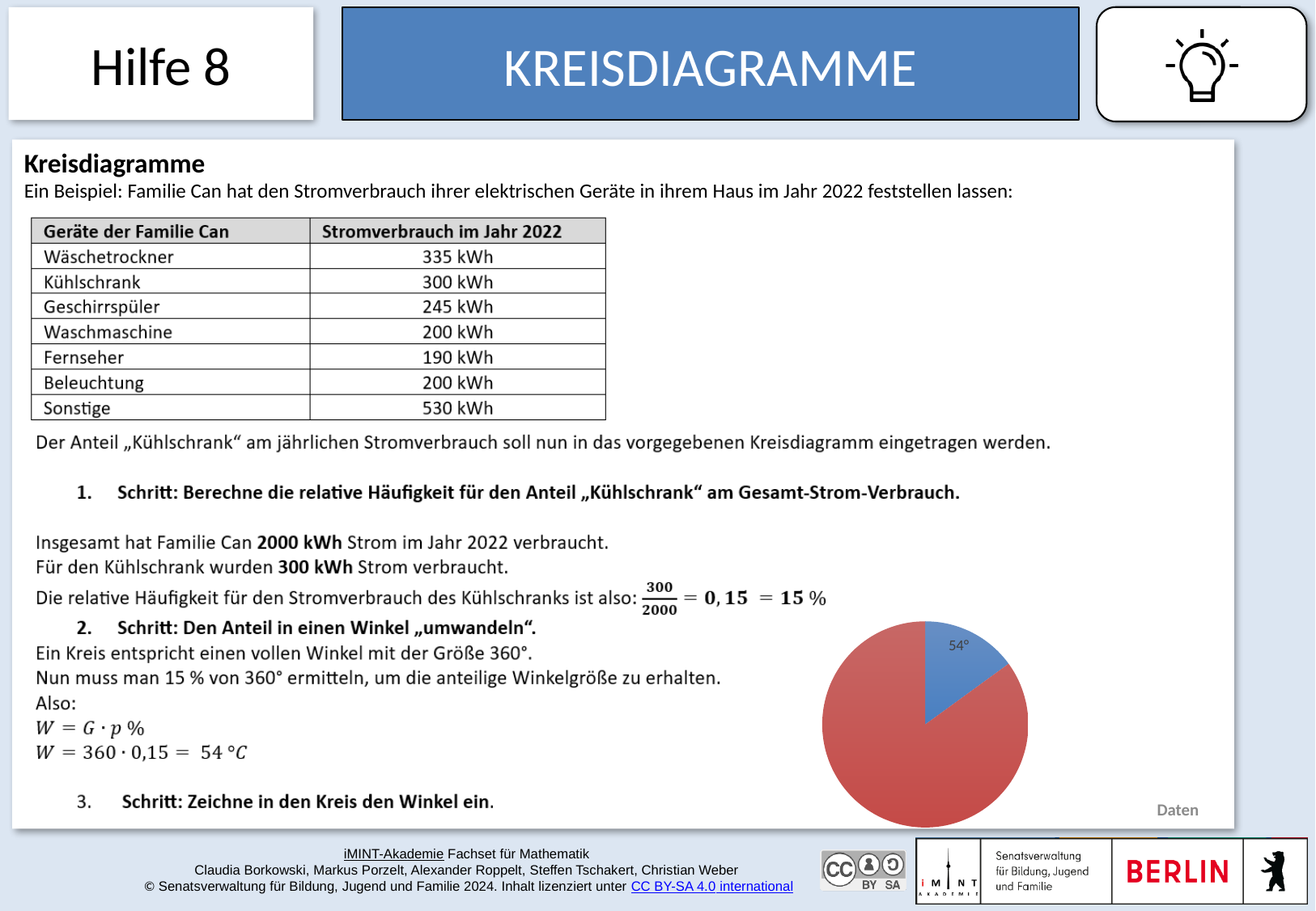
Which colour is the largest slice of the pie chart? red What share of the whole circle does the 54° slice of the pie chart represent? 15 % What angle is printed on the blue slice of the pie chart? 54° Does the pie chart have a legend? No Is the angle of the blue slice in the pie chart greater or less than 90°? less Which slice of the pie chart is larger, the blue one or the red one? the red one Which colour is the smallest slice of the pie chart? blue How many slices does the pie chart have? 2 What kind of chart is shown at the bottom right of the slide? pie chart Which device does the 54° slice of the pie chart represent, according to the slide text? Kühlschrank